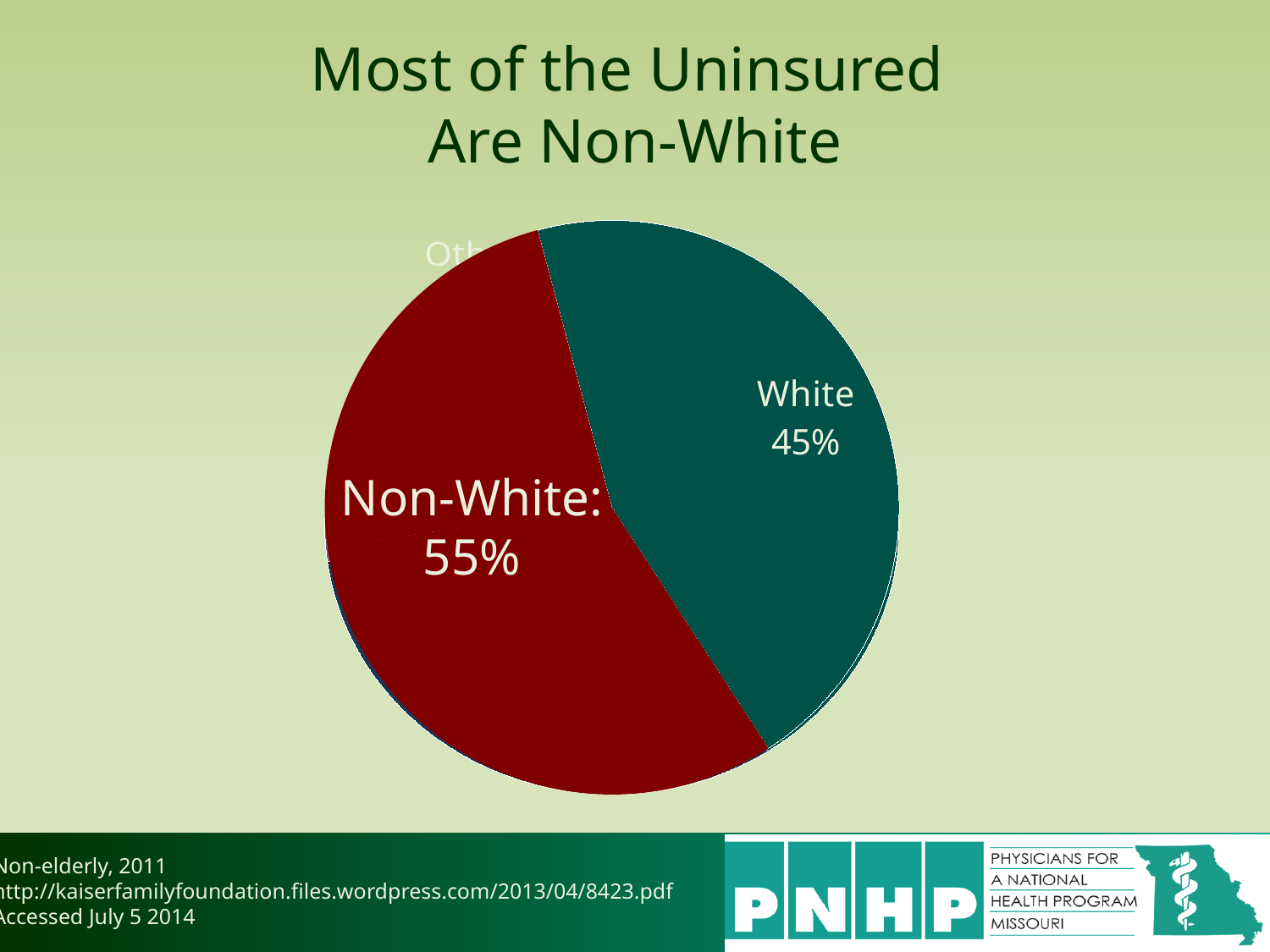
Is the share for Non-White larger or smaller than the share for White? larger Which group has the smaller share of the pie chart? White What is the title of the slide containing the pie chart? Most of the Uninsured Are Non-White What share of the pie does the Non-White slice represent? 55% By how many percentage points does the Non-White share exceed the White share? 10 percentage points What kind of chart is shown on the slide? pie chart What percentage of the uninsured are Non-White according to the pie chart? 55% Which group has the larger share of the pie chart, White or Non-White? Non-White What colour is the White slice of the pie chart? teal (dark green) Is the White share of the pie greater or less than 50%? less What percentage of the uninsured are White according to the pie chart? 45%